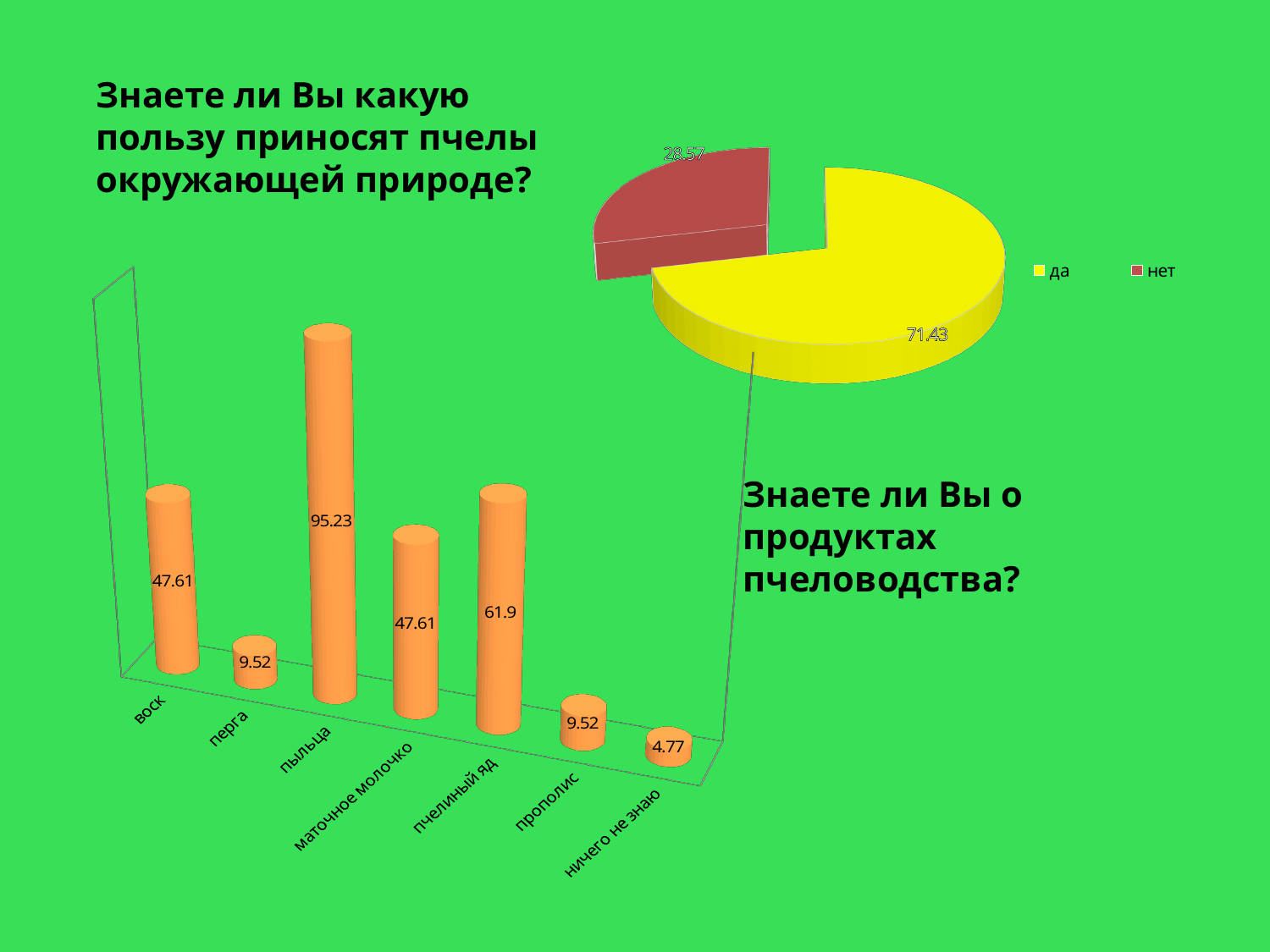
What kind of chart is the chart on the left of the slide? bar chart In the bar chart on the left, which category has the lowest value? ничего не знаю How many categories are shown in the bar chart on the left? 7 In the bar chart on the left, which is larger: the value for воск or the value for перга? воск In the bar chart on the left, what is the difference between the values for пыльца and пчелиный яд? 33.33 In the bar chart on the left, what is the value for ничего не знаю? 4.77 In the bar chart on the left, what is the value for пыльца? 95.23 How many entries does the legend of the pie chart in the top right list? 2 In the pie chart in the top right, what is the value for да? 71.43 In the bar chart on the left, which category has the highest value? пыльца In the bar chart on the left, what is the value for пчелиный яд? 61.9 In the pie chart in the top right, what is the value for нет? 28.57